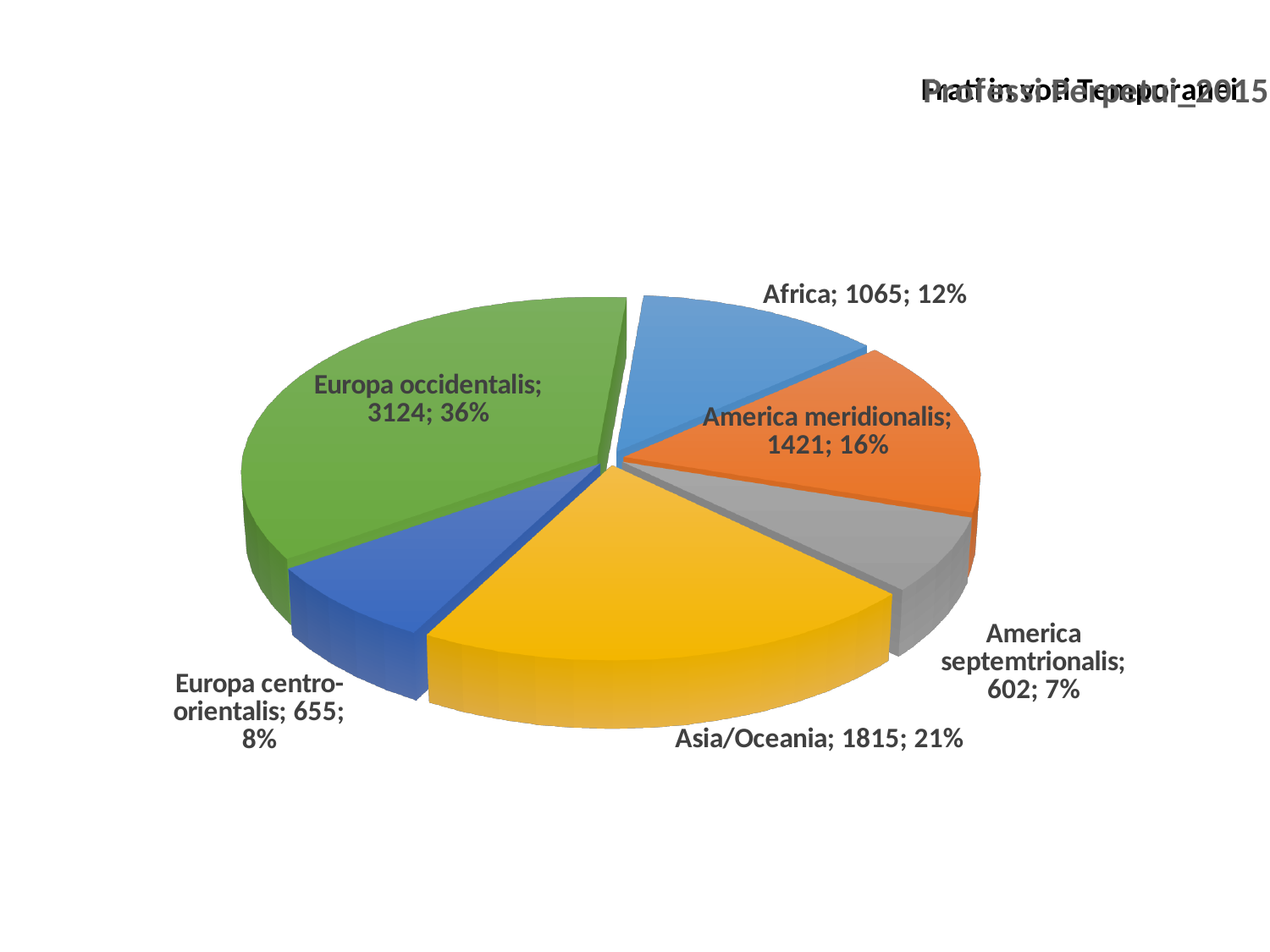
What is the value for Asia/Oceania? 1815 What share of the pie does Europa centro-orientalis represent? 8% What is the value for Africa? 1065 Which category has the largest slice? Europa occidentalis What is the value for America septemtrionalis? 602 What is the total of all the values shown in the pie chart? 8682 Which category has the smallest slice? America septemtrionalis What kind of chart is shown on the slide? pie chart How many slices does the pie chart have? 6 Which is larger, the value for Asia/Oceania or the value for America meridionalis? Asia/Oceania What share of the pie does Europa occidentalis represent? 36% What is the difference between the values for America meridionalis and Africa? 356